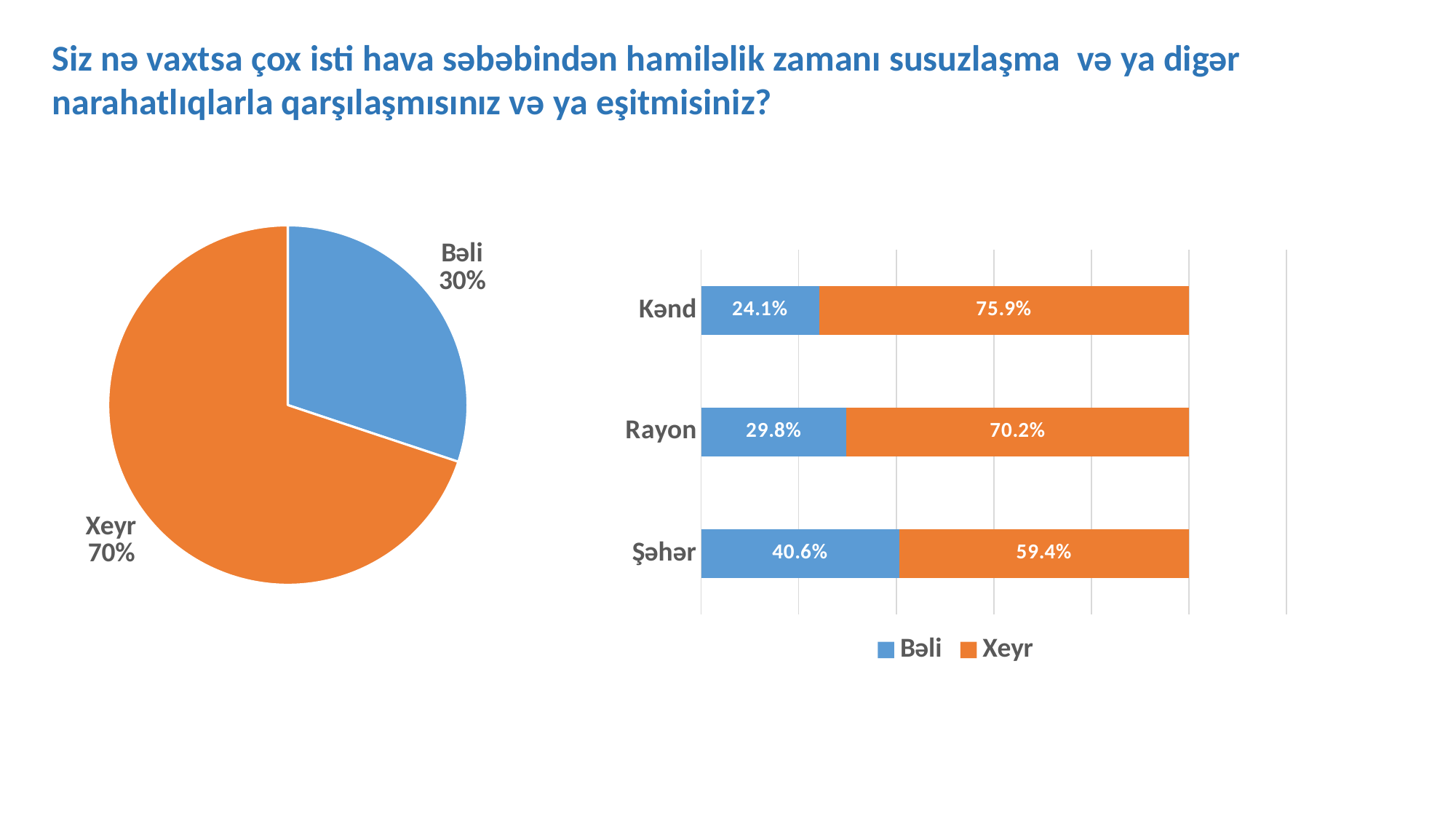
In the bar chart on the right, what is the Xeyr value for Rayon? 70.2% In the pie chart on the left, which slice is larger, Bəli or Xeyr? Xeyr In the bar chart on the right, what is the difference between the Xeyr values for Kənd and Şəhər? 16.5% In the bar chart on the right, what is the Bəli value for Şəhər? 40.6% In the pie chart on the left, what share is labelled for Bəli? 30% In the pie chart on the left, what share is labelled for Xeyr? 70% In the pie chart on the left, how many slices are there? 2 In the bar chart on the right, which category has the lowest Xeyr value? Şəhər In the bar chart on the right, which category has the highest Bəli value? Şəhər In the bar chart on the right, how many series does the legend list? 2 What type of chart is shown on the right side of the slide? Bar chart In the bar chart on the right, what is the Bəli value for Kənd? 24.1%